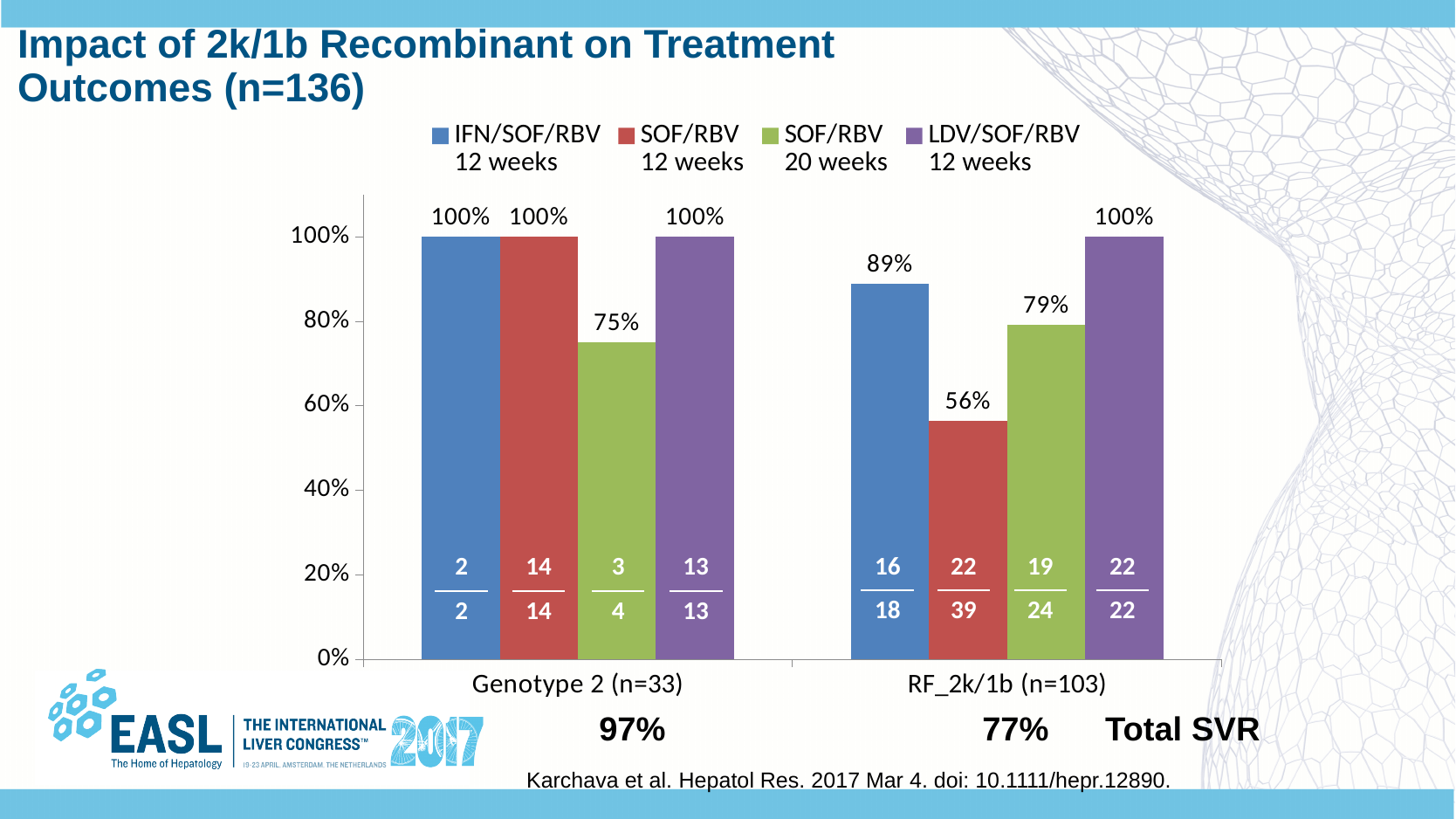
Which is larger: the IFN/SOF/RBV 12 weeks value for Genotype 2 (n=33) or for RF_2k/1b (n=103)? Genotype 2 (n=33) What is the value for LDV/SOF/RBV 12 weeks in the RF_2k/1b (n=103) group? 100% What is the SVR value for SOF/RBV 12 weeks in the RF_2k/1b (n=103) group? 56% Which treatment regimen has the lowest value in the Genotype 2 (n=33) group? SOF/RBV 20 weeks What is the value for IFN/SOF/RBV 12 weeks in the RF_2k/1b (n=103) group? 89% What kind of chart is shown on the slide? Bar chart Which treatment regimen has the lowest value in the RF_2k/1b (n=103) group? SOF/RBV 12 weeks What is the difference between the SOF/RBV 12 weeks values for Genotype 2 (n=33) and RF_2k/1b (n=103)? 44% What is the value for SOF/RBV 20 weeks in the Genotype 2 (n=33) group? 75% How many categories are shown on the x axis? 2 What is the difference between the SOF/RBV 20 weeks value and the SOF/RBV 12 weeks value in the RF_2k/1b (n=103) group? 23% How many series does the legend list? 4